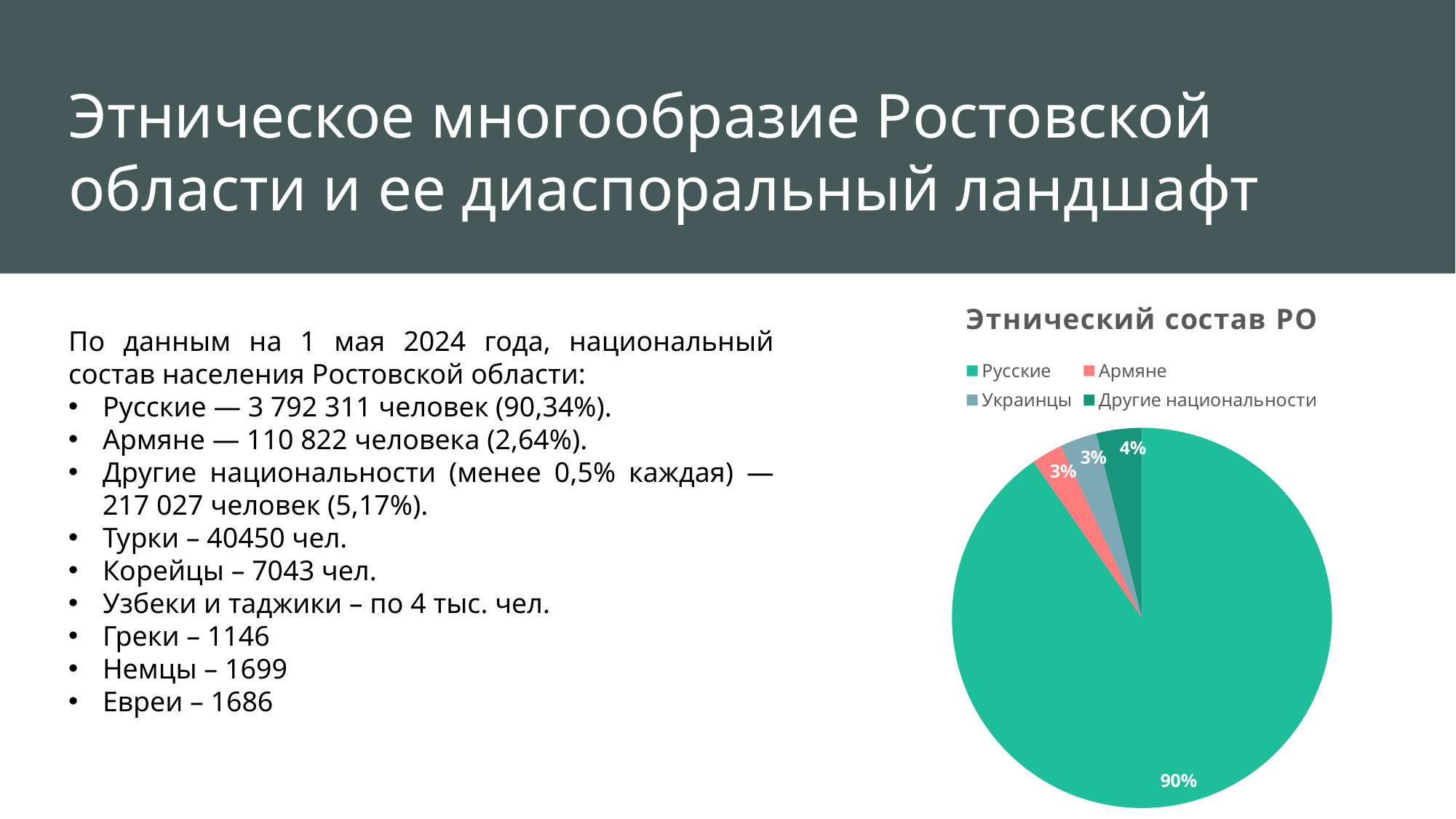
What is the value shown for Другие национальности in the pie chart? 4% Which category has the largest slice in the pie chart? Русские Which legend entry is shown in red/pink in the pie chart? Армяне What is the title of the chart on the slide? Этнический состав РО What is the difference in percentage points between the Русские slice and the Другие национальности slice? 86 What is the value shown for Армяне in the pie chart? 3% How many entries does the chart legend list? 4 What kind of chart is shown on the slide? pie chart What is the value shown for Украинцы in the pie chart? 3% Which is larger in the pie chart, Другие национальности or Армяне? Другие национальности What share of the pie does Русские take? 90% How many slices does the pie chart have? 4